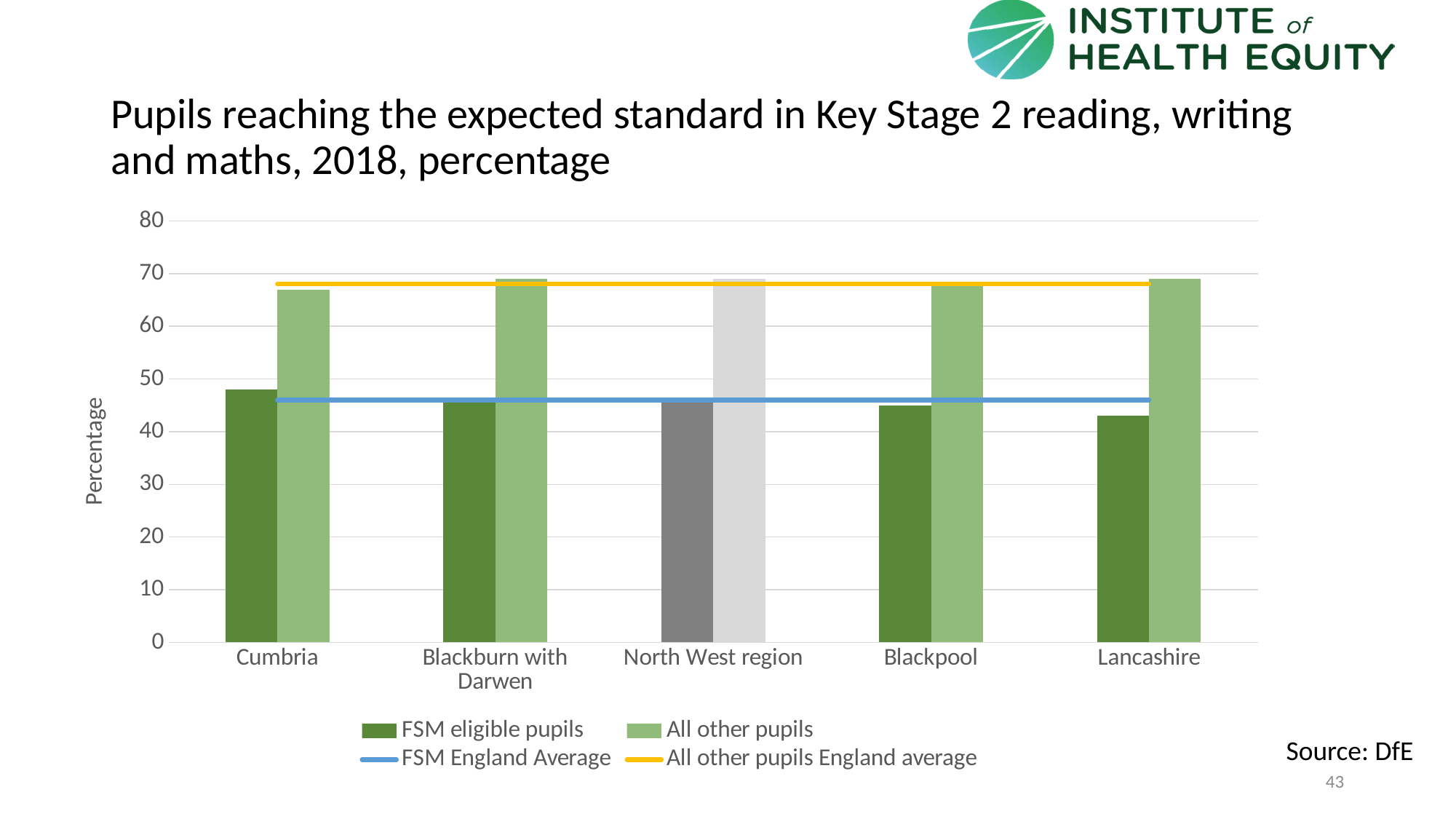
Which category has the highest value for FSM eligible pupils? Cumbria Is the value for All other pupils in Lancashire greater or less than 60? greater Which is larger: the FSM eligible pupils value for Cumbria or for Lancashire? Cumbria What is the label on the vertical axis? Percentage Is the value for All other pupils in Cumbria greater or less than 70? less Which category has the lowest value for FSM eligible pupils? Lancashire What kind of chart is shown on the slide? combination bar and line chart In Blackpool, which is larger: the value for FSM eligible pupils or for All other pupils? All other pupils Is the value for FSM eligible pupils in Lancashire greater or less than 50? less How many categories are shown on the x axis? 5 How many series does the legend list? 4